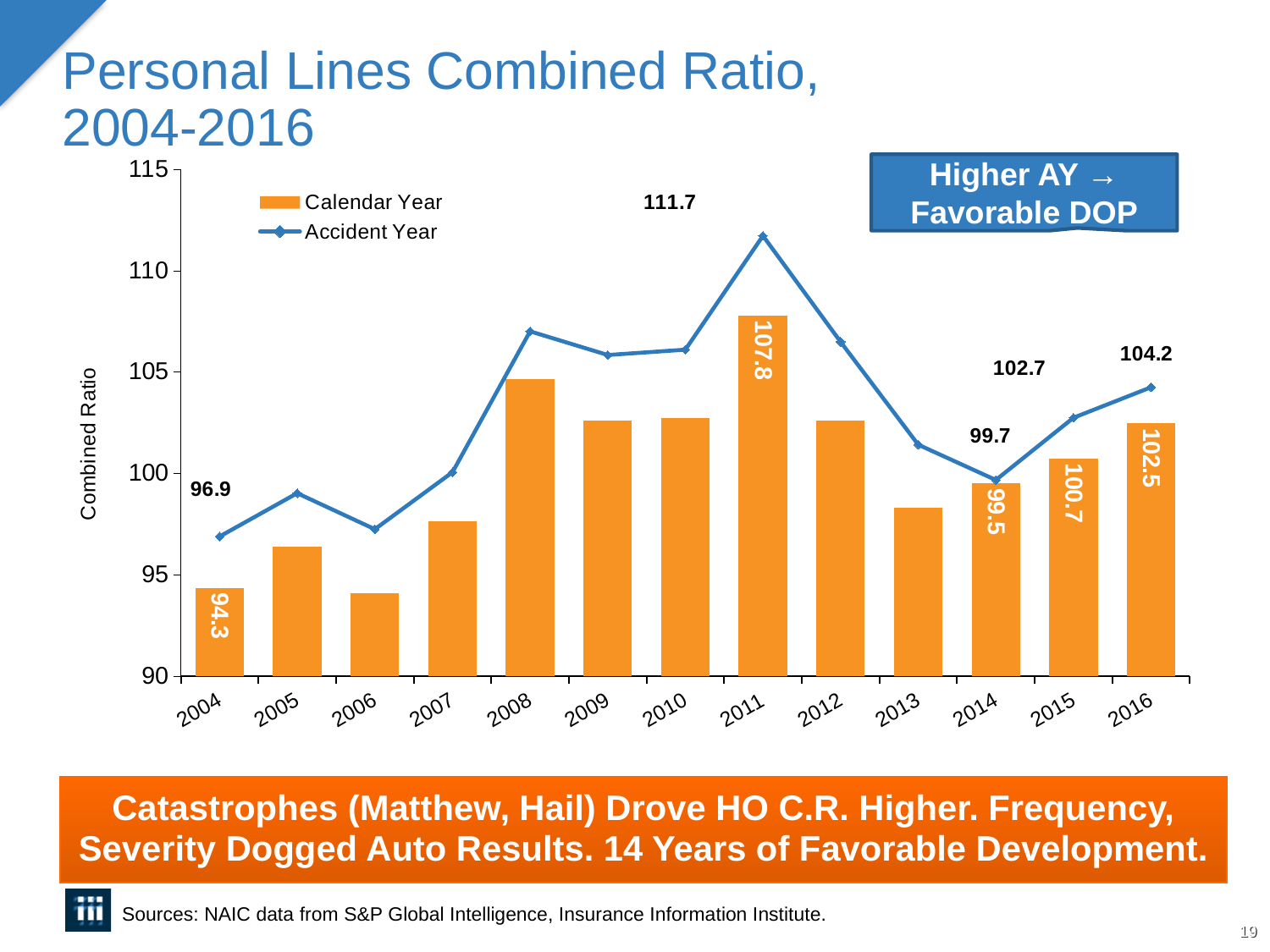
What is the Accident Year combined ratio for 2016? 104.2 Which is larger in 2014, the Calendar Year or the Accident Year combined ratio? Accident Year What is the Accident Year combined ratio for 2011? 111.7 How many years are shown on the x axis? 13 What is the Calendar Year combined ratio for 2015? 100.7 Which year has the lowest Calendar Year combined ratio? 2006 Which year has the highest Accident Year combined ratio? 2011 What is the Calendar Year combined ratio for 2004? 94.3 How many series does the legend list? 2 Is the Calendar Year combined ratio for 2008 greater or less than 100? greater What is the difference between the Accident Year and Calendar Year combined ratios in 2011? 3.9 What is the Calendar Year combined ratio for 2011? 107.8